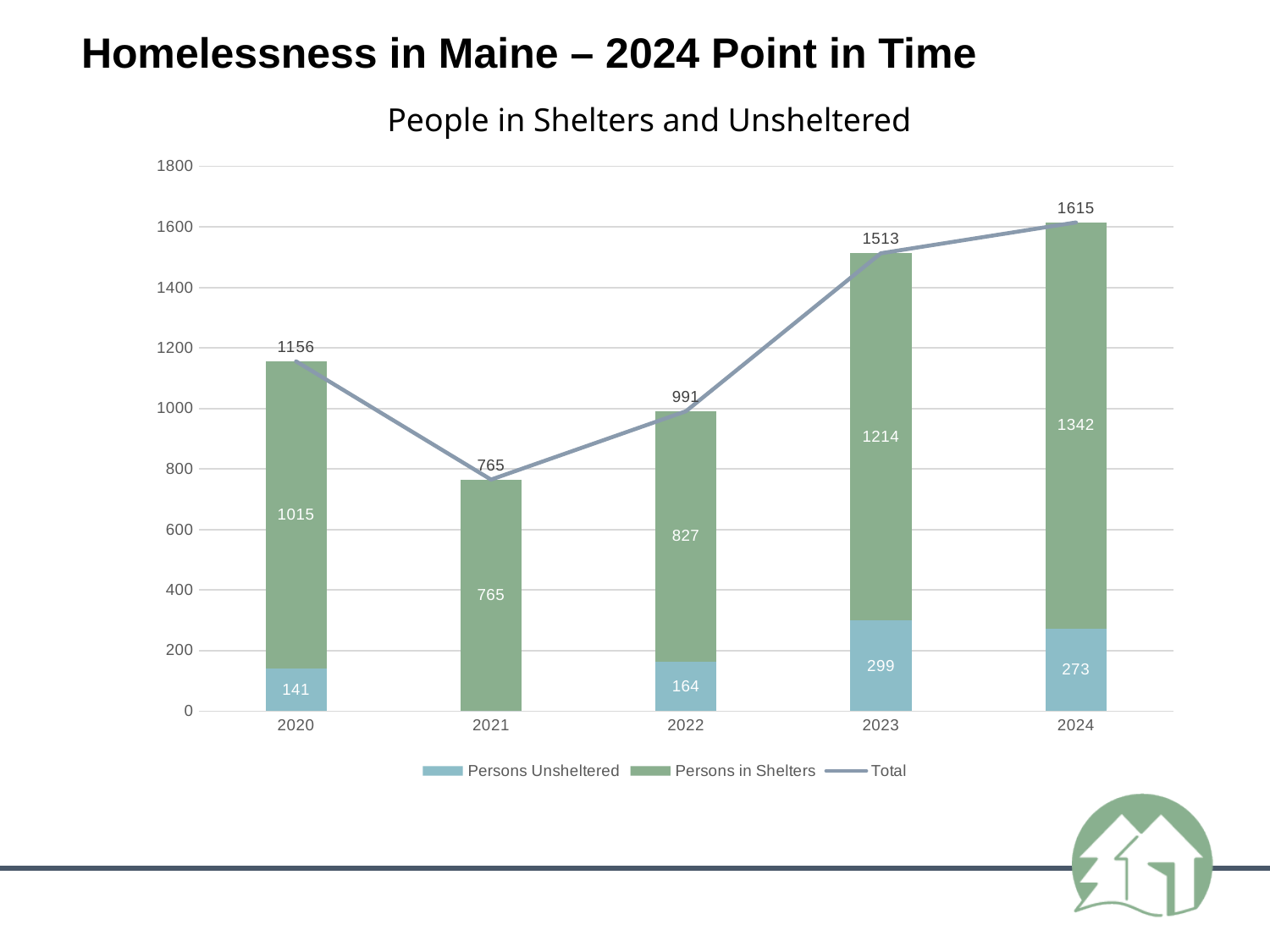
Which is larger, Persons Unsheltered in 2023 or Persons Unsheltered in 2024? 2023 What is the title of the chart? People in Shelters and Unsheltered Is the Total for 2022 greater or less than 1000? less What is the value for Persons Unsheltered in 2020? 141 What is the difference between the Total for 2024 and the Total for 2023? 102 What is the Total for 2021? 765 How many years are shown on the x axis? 5 What kind of chart is this? Stacked bar chart with a line Which year has the highest Total? 2024 What is the value for Persons in Shelters in 2023? 1214 How many series does the legend list? 3 Which year has the lowest Total? 2021